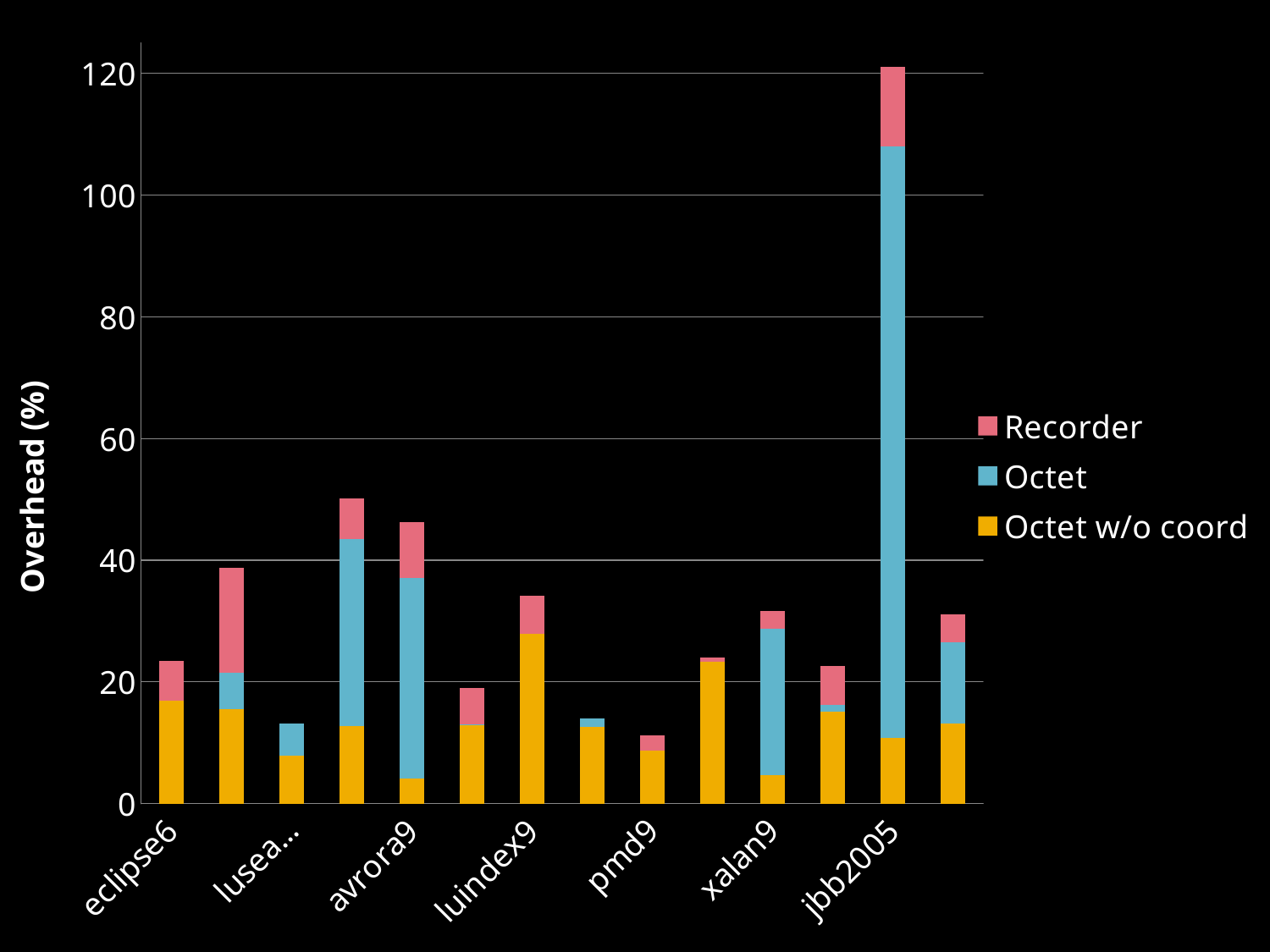
Which has the larger total overhead, jbb2005 or eclipse6? jbb2005 Which has the larger total overhead, avrora9 or luindex9? avrora9 How many category labels are shown on the x axis? 7 Which labeled category has the highest total overhead? jbb2005 What are the series names listed in the legend? Recorder, Octet, Octet w/o coord Is the total overhead for jbb2005 greater or less than 100? greater How many series does the legend list? 3 Is the total overhead for luindex9 greater or less than 40? less Is the total overhead for avrora9 greater or less than 40? greater What type of chart is shown on the slide? stacked bar chart What is the title of the y axis? Overhead (%)